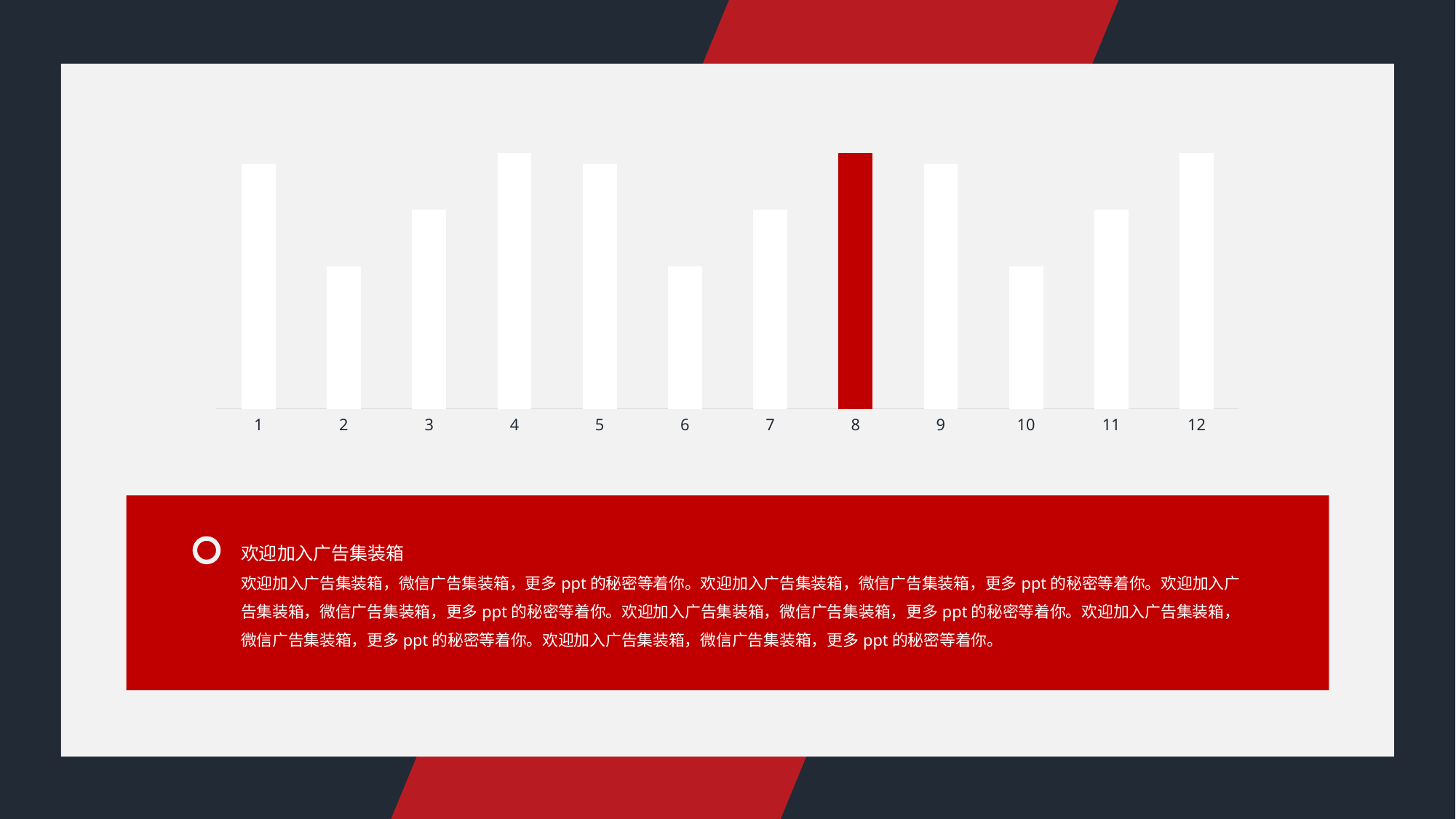
Which bar is taller, category 1 or category 2? 1 Which bar is taller, category 5 or category 6? 5 Which bar is taller, category 11 or category 12? 12 How many bars (categories) does the chart show? 12 Which category's bar is coloured red instead of white? 8 What kind of chart is shown on the slide? bar chart What is the label of the first category on the x axis? 1